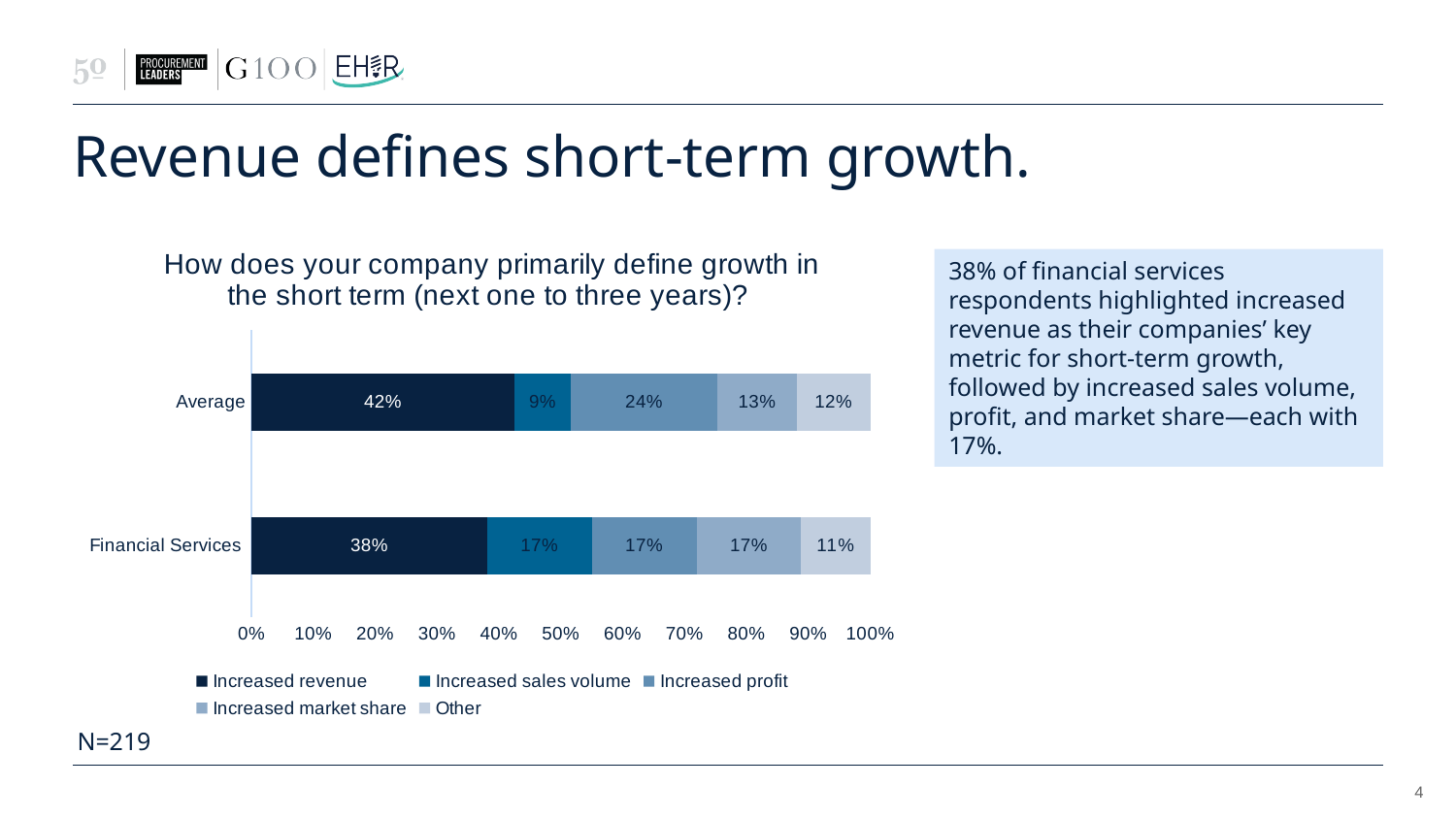
Which series has the highest value in the Average bar? Increased revenue What percentage of Financial Services respondents chose Increased revenue? 38% What kind of chart is shown on the slide? Stacked bar chart What is the value for Increased profit in the Average bar? 24% What is the value for Increased sales volume in the Financial Services bar? 17% How many series does the legend list? 5 What is the difference between the Increased revenue values for Average and Financial Services? 4% How many categories are shown on the chart? 2 Which series has the lowest value in the Average bar? Increased sales volume What is the value for Other in the Financial Services bar? 11% What percentage of Average respondents chose Increased revenue? 42% Which is larger: Increased sales volume for Average or for Financial Services? Financial Services